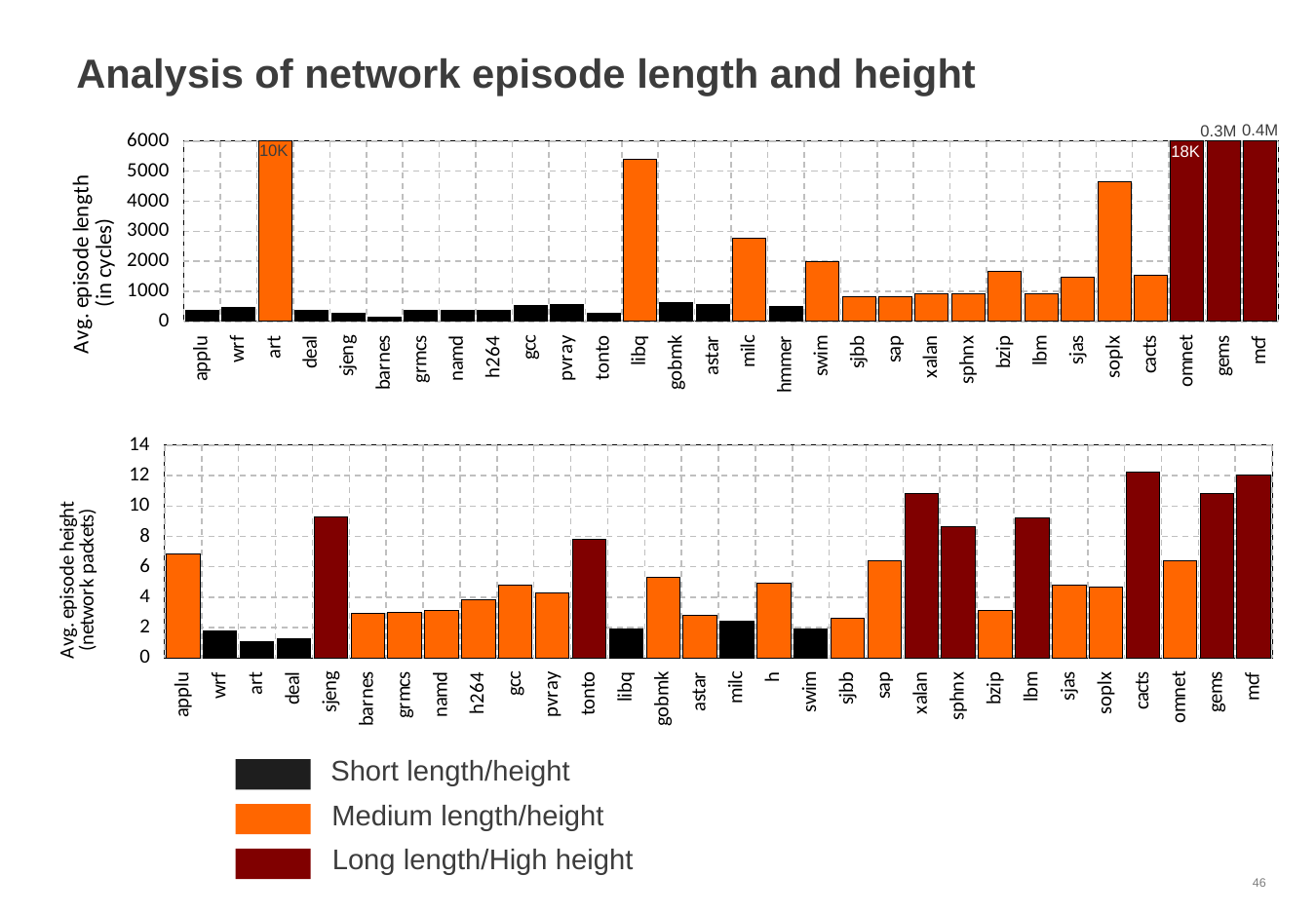
In the top chart (Avg. episode length), what value is labelled for gems? 0.3M In the bottom chart (Avg. episode height), is the value for xalan greater or less than 10? greater In the top chart (Avg. episode length), is the value for libq greater or less than 5000? greater How many benchmarks are shown on the x axis of the bottom chart (Avg. episode height)? 30 In the top chart (Avg. episode length), what value is labelled for art? 10K What kind of chart is the top chart (Avg. episode length)? bar chart In the bottom chart (Avg. episode height), which is larger, the value for sjeng or the value for tonto? sjeng In the top chart (Avg. episode length), which benchmark has the highest average episode length? mcf In the top chart (Avg. episode length), what value is labelled for mcf? 0.4M In the top chart (Avg. episode length), what value is labelled for omnet? 18K How many categories does the legend at the bottom of the slide list? 3 In the top chart (Avg. episode length), is the value for milc greater or less than 3000? less